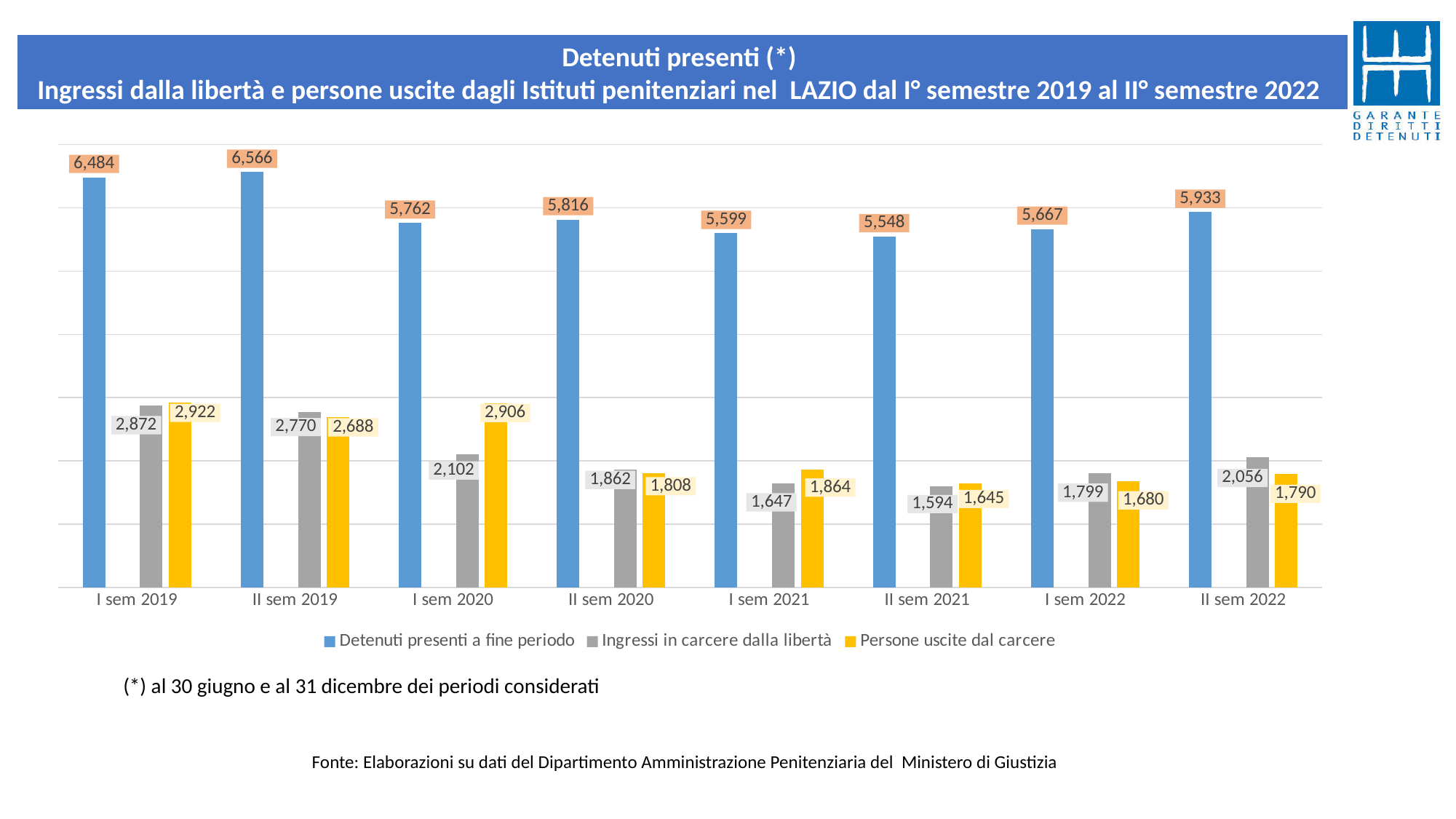
Which colour represents 'Persone uscite dal carcere' in the chart? Yellow What is the difference between 'Detenuti presenti a fine periodo' in II sem 2019 and in II sem 2021? 1,018 In which period is 'Ingressi in carcere dalla libertà' lowest? II sem 2021 How many series does the legend list? 3 Which is larger in I sem 2021: 'Ingressi in carcere dalla libertà' or 'Persone uscite dal carcere'? Persone uscite dal carcere Does 'Detenuti presenti a fine periodo' rise or fall from II sem 2021 to II sem 2022? Rise What is the value of 'Detenuti presenti a fine periodo' for I sem 2019? 6,484 What kind of chart is shown on the slide? Bar chart What is the value of 'Persone uscite dal carcere' for II sem 2022? 1,790 What is the value of 'Ingressi in carcere dalla libertà' for I sem 2020? 2,102 In which period is 'Detenuti presenti a fine periodo' highest? II sem 2019 How many periods are shown on the x axis? 8